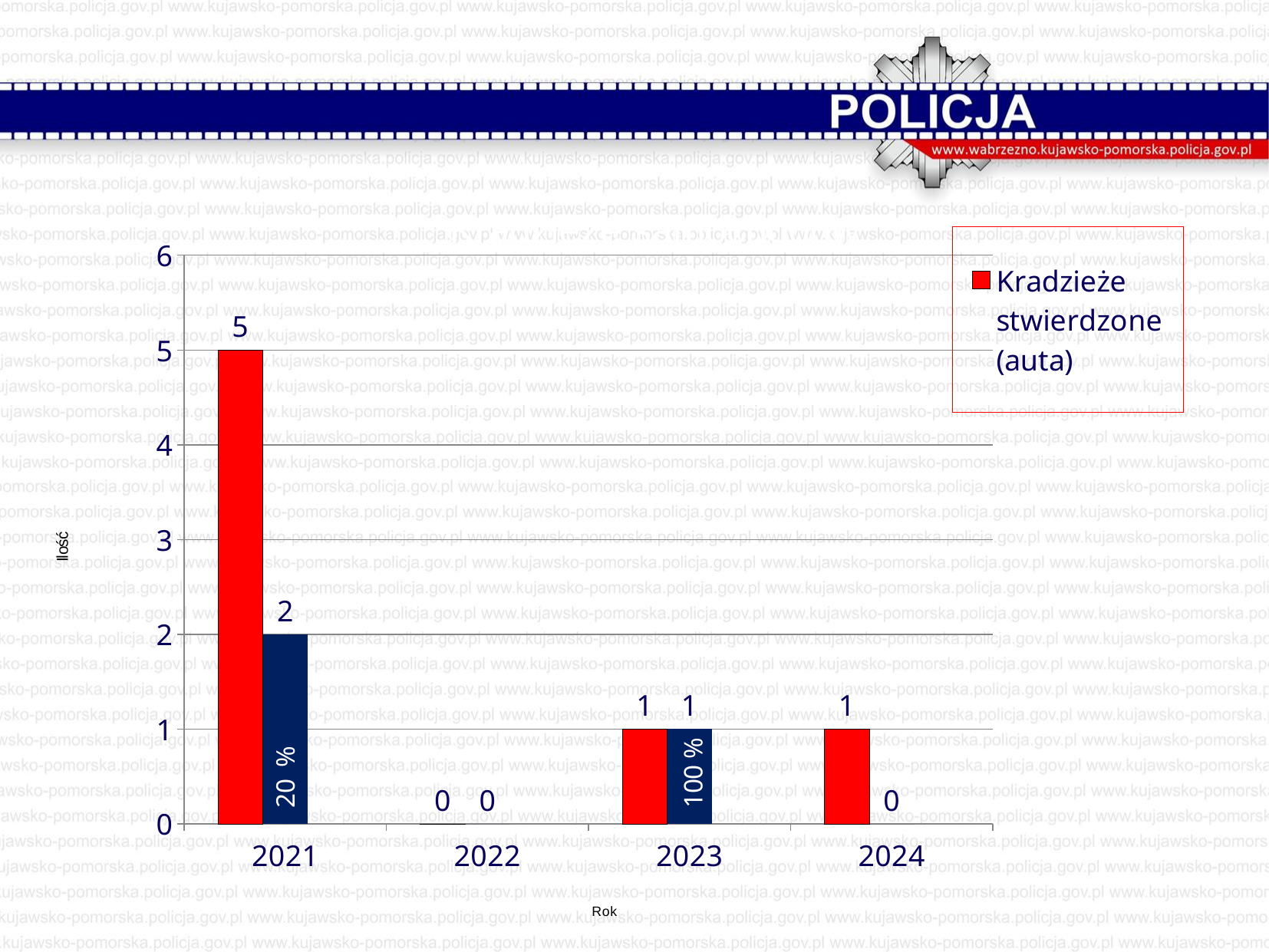
What is the value of Kradzieże stwierdzone (auta) for 2021? 5 What is the value of Kradzieże stwierdzone (auta) for 2023? 1 What kind of chart is shown on the slide? Bar chart Which year has the highest value for Kradzieże stwierdzone (auta)? 2021 What percentage label is printed on the dark blue bar for 2021? 20 % How many years are shown on the x axis? 4 What is the value of the dark blue bar for 2021? 2 What is the value of Kradzieże stwierdzone (auta) for 2022? 0 What is the label of the x axis? Rok What percentage label is printed on the dark blue bar for 2023? 100 % Which is larger for 2021: the red bar (Kradzieże stwierdzone (auta)) or the dark blue bar? The red bar (Kradzieże stwierdzone (auta)) What is the difference between the Kradzieże stwierdzone (auta) values for 2021 and 2023? 4